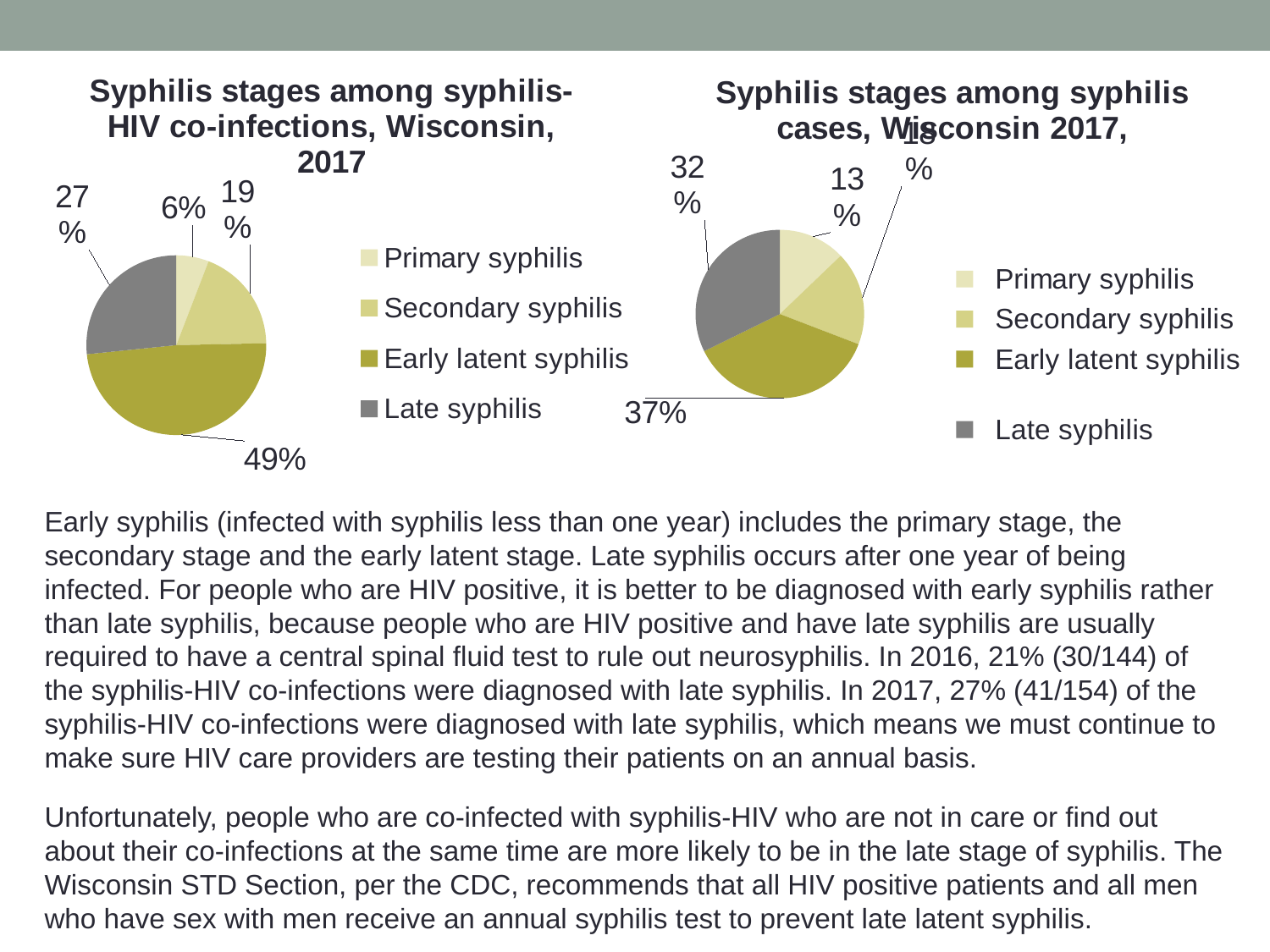
In the right chart (syphilis cases, Wisconsin 2017), what percentage is Early latent syphilis? 37% In the right chart (syphilis cases, Wisconsin 2017), what percentage is Primary syphilis? 13% In the left chart (syphilis-HIV co-infections), what percentage is Late syphilis? 27% What kind of chart is the left chart, 'Syphilis stages among syphilis-HIV co-infections, Wisconsin, 2017'? Pie chart In the left chart (syphilis-HIV co-infections), which syphilis stage has the largest slice? Early latent syphilis In the left chart (syphilis-HIV co-infections), how many percentage points larger is Early latent syphilis than Late syphilis? 22 percentage points In the left chart (syphilis-HIV co-infections), what percentage is Primary syphilis? 6% How many categories does the legend of the right chart, 'Syphilis stages among syphilis cases, Wisconsin 2017', list? 4 In the right chart (syphilis cases, Wisconsin 2017), what percentage is Late syphilis? 32% In the left chart (syphilis-HIV co-infections), what share of cases is Early latent syphilis? 49% In the left chart (syphilis-HIV co-infections), which syphilis stage has the smallest slice? Primary syphilis Is the Late syphilis share larger in the left chart (syphilis-HIV co-infections) or the right chart (all syphilis cases)? Right chart (all syphilis cases)